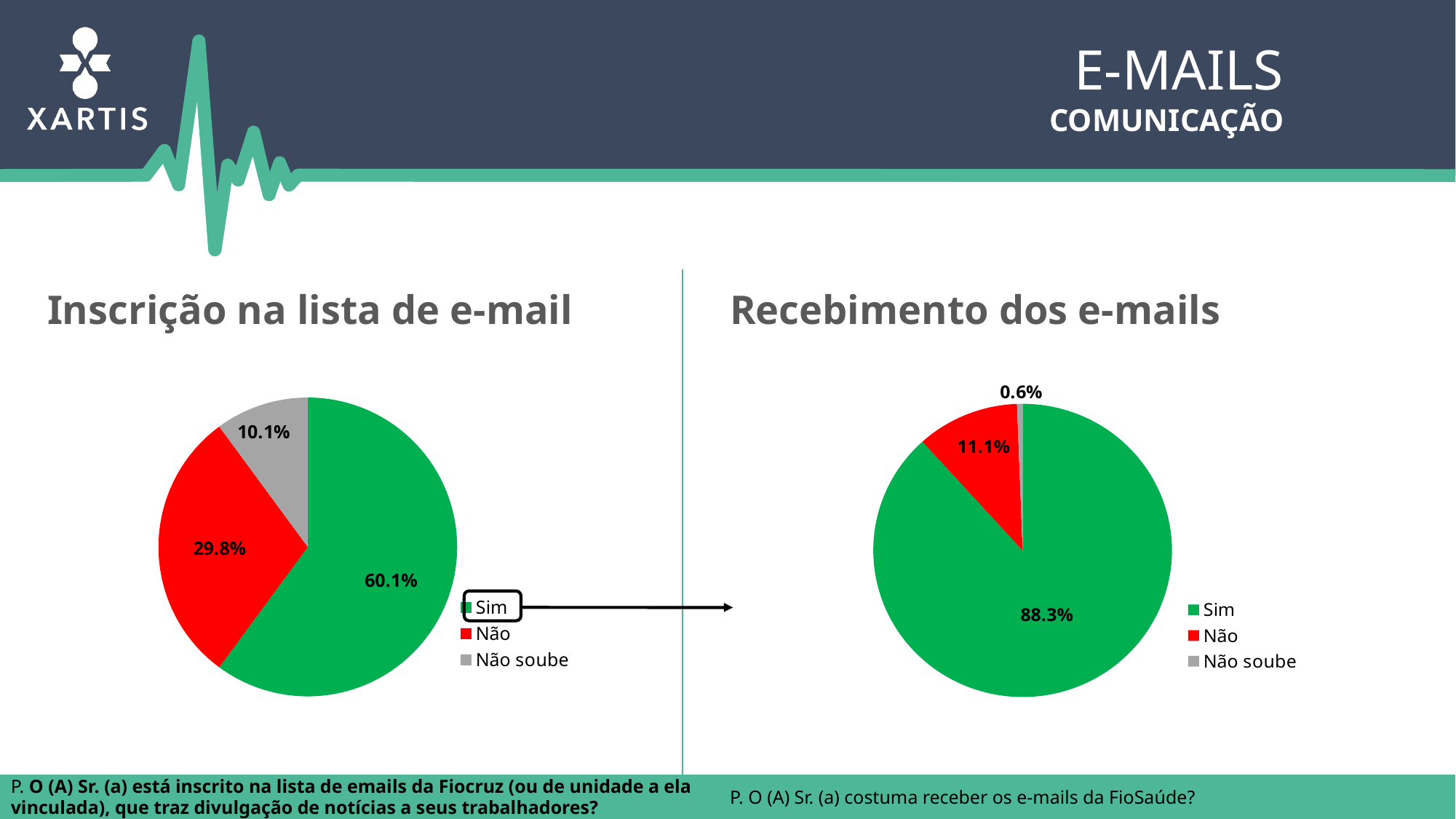
In the 'Inscrição na lista de e-mail' chart, what is the difference in percentage points between 'Sim' and 'Não'? 30.3 In the 'Recebimento dos e-mails' chart, which category has the smallest slice? Não soube In the 'Inscrição na lista de e-mail' chart, what share does 'Não soube' have? 10.1% In the 'Inscrição na lista de e-mail' chart, what share does 'Sim' have? 60.1% What type of chart is used in 'Recebimento dos e-mails'? Pie chart How many categories does the legend of the 'Inscrição na lista de e-mail' chart list? 3 In the 'Recebimento dos e-mails' chart, what share does 'Sim' have? 88.3% In the 'Inscrição na lista de e-mail' chart, which category has the largest slice? Sim In the 'Inscrição na lista de e-mail' chart, what share does 'Não' have? 29.8% Which chart has the larger 'Não' share, 'Inscrição na lista de e-mail' or 'Recebimento dos e-mails'? Inscrição na lista de e-mail In the 'Recebimento dos e-mails' chart, what share does 'Não soube' have? 0.6% In the 'Recebimento dos e-mails' chart, what share does 'Não' have? 11.1%